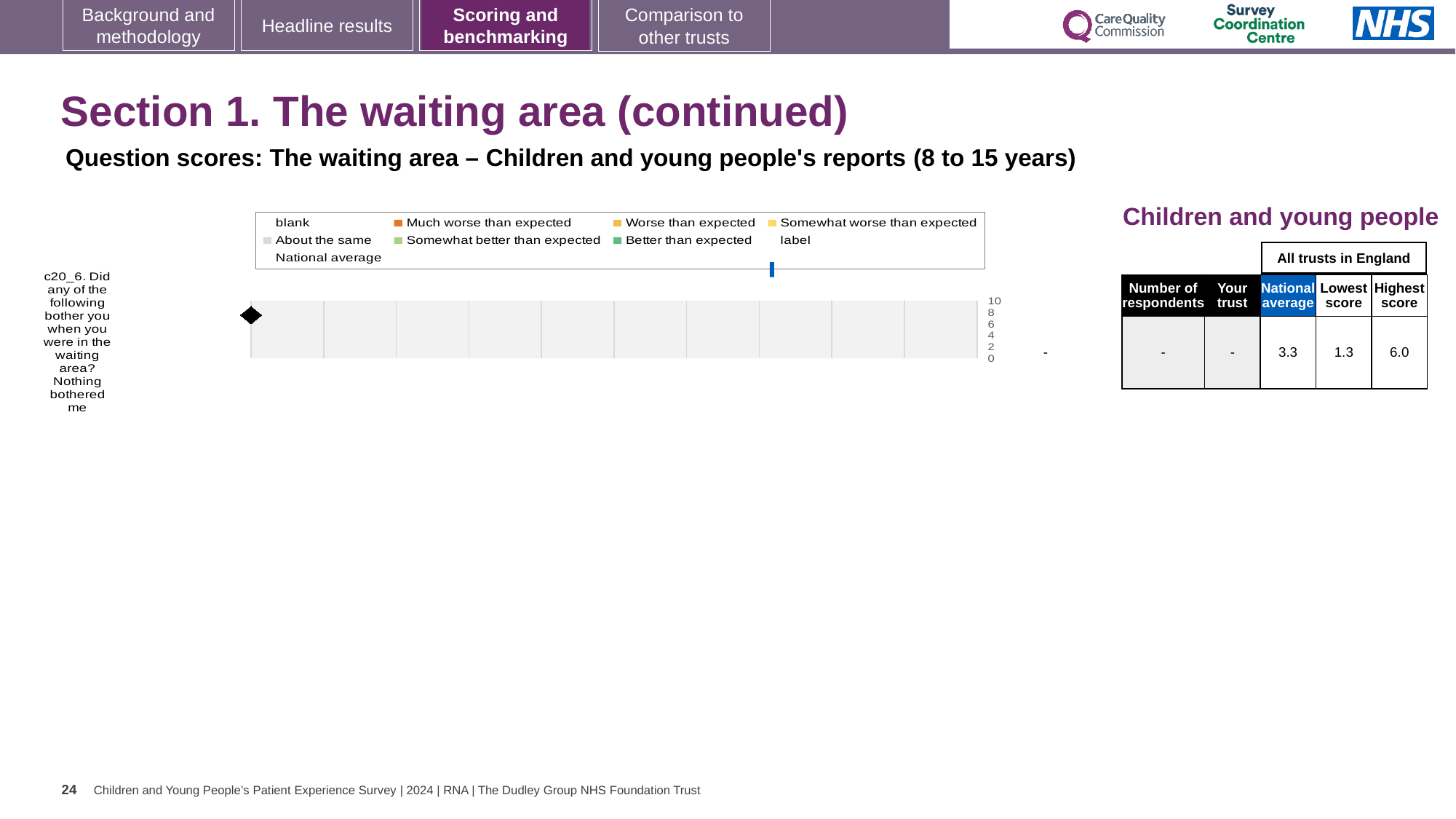
In the table next to the chart, which is larger for question c20_6: the National average or the Lowest score? National average In the table next to the chart, what is the Highest score across all trusts in England for question c20_6? 6.0 What is the highest tick value shown on the chart's value axis? 10 In the table next to the chart, what value is shown for Your trust for question c20_6? - How many question categories are plotted on the chart? 1 Which legend entry is shown with a dark orange marker? Much worse than expected What kind of chart is shown on the slide? bar chart In the table next to the chart, what is the National average score for question c20_6? 3.3 In the table next to the chart, what is the difference between the Highest score and the Lowest score for question c20_6? 4.7 In the table next to the chart, what is the Lowest score across all trusts in England for question c20_6? 1.3